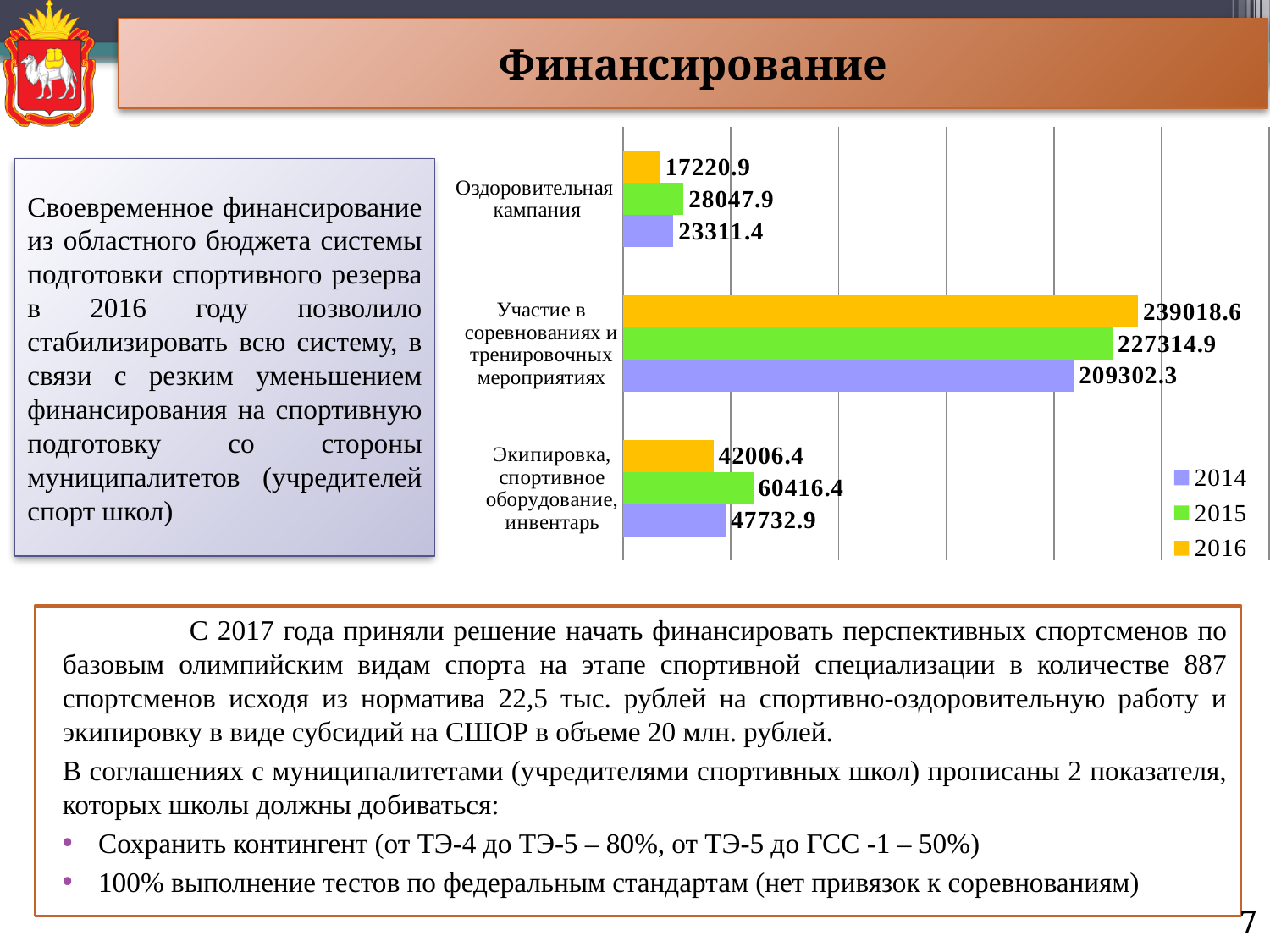
How many categories are shown on the chart? 3 How many series does the legend list? 3 What is the 2014 value for «Экипировка, спортивное оборудование, инвентарь»? 47732.9 Which colour represents the 2015 series in the legend? Green What is the 2016 value for «Участие в соревнованиях и тренировочных мероприятиях»? 239018.6 Which category has the highest value in 2016? Участие в соревнованиях и тренировочных мероприятиях Which category has the lowest value in 2014? Оздоровительная кампания What is the difference between the 2016 and 2015 values for «Участие в соревнованиях и тренировочных мероприятиях»? 11703.7 What kind of chart is shown on the slide? Bar chart What is the difference between the 2015 and 2016 values for «Экипировка, спортивное оборудование, инвентарь»? 18410.0 For «Оздоровительная кампания», which year has the larger value, 2014 or 2016? 2014 What is the 2015 value for «Оздоровительная кампания»? 28047.9